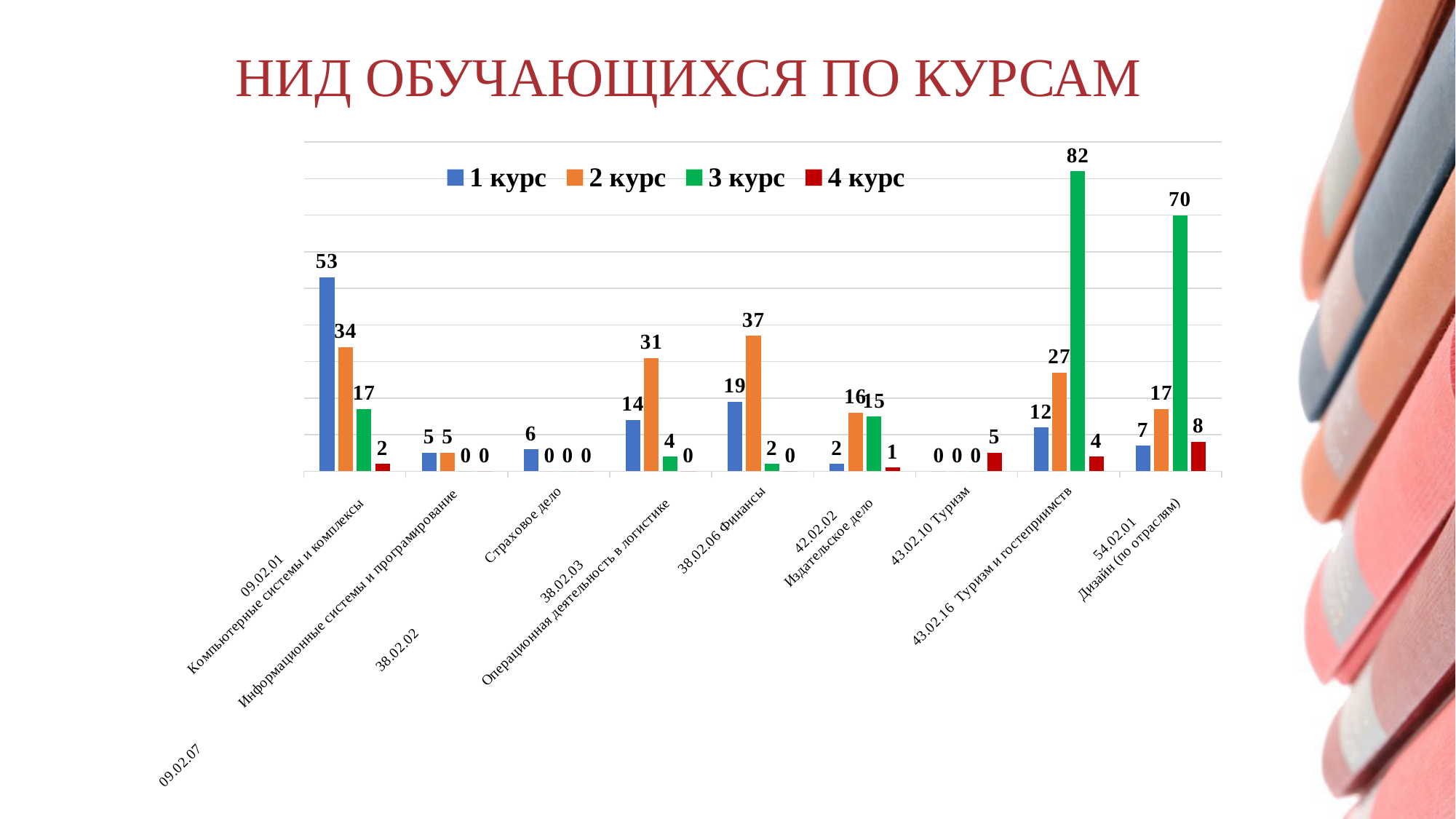
What is the value for 4 курс in 54.02.01 Дизайн (по отраслям)? 8 What is the difference between the 3 курс values for 43.02.16 Туризм и гостеприимств and 54.02.01 Дизайн (по отраслям)? 12 What is the title of the chart? НИД ОБУЧАЮЩИХСЯ ПО КУРСАМ Which category has the highest value for 1 курс? 09.02.01 Компьютерные системы и комплексы How many categories (specialities) are shown on the x axis? 9 Which category has the highest value for 3 курс? 43.02.16 Туризм и гостеприимств What is the value for 1 курс in 09.02.01 Компьютерные системы и комплексы? 53 How many series does the legend list? 4 Which is larger in 38.02.03 Операционная деятельность в логистике: the value for 1 курс or for 2 курс? 2 курс What is the value for 2 курс in 38.02.06 Финансы? 37 What is the value for 3 курс in 43.02.16 Туризм и гостеприимств? 82 What type of chart is shown on the slide? bar chart